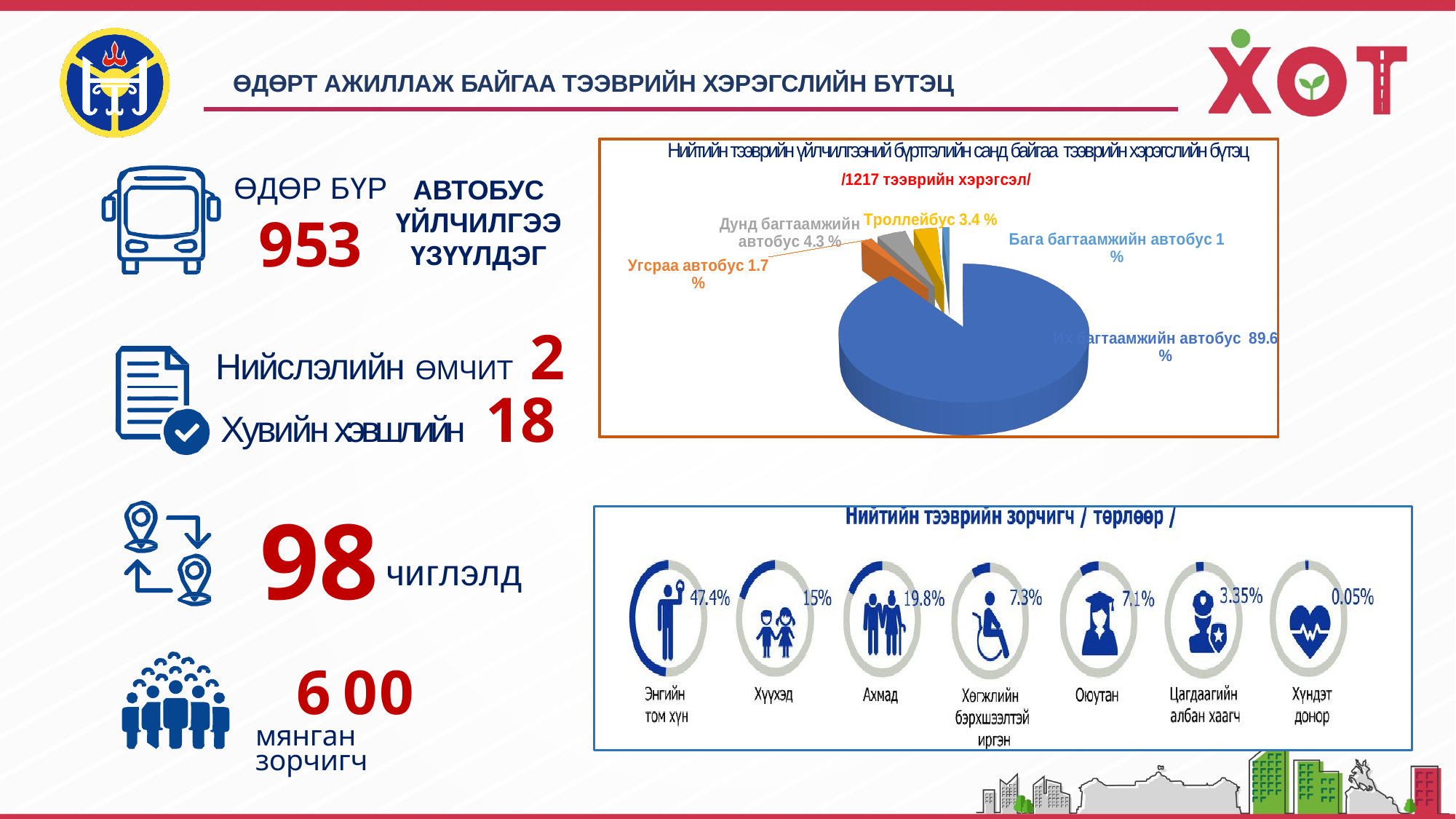
In the bottom-right infographic 'Нийтийн тээврийн зорчигч / төрлөөр /', what percentage is shown for Ахмад? 19.8% In the pie chart, what share is labelled for Их багтаамжийн автобус? 89.6 % What kind of chart is shown in the top-right box titled 'Нийтийн тээврийн үйлчилгээний бүртгэлийн санд байгаа тээврийн хэрэгслийн бүтэц'? Pie chart In the pie chart, which category has the smallest slice? Бага багтаамжийн автобус In the pie chart, how many slices (categories) are shown? 5 In the pie chart, what share is labelled for Троллейбус? 3.4 % According to the pie chart's title, how many vehicles are in the registry? 1217 In the pie chart, what share is labelled for Бага багтаамжийн автобус? 1 % In the pie chart, which category has the largest slice? Их багтаамжийн автобус In the pie chart, what share is labelled for Дунд багтаамжийн автобус? 4.3 % In the pie chart, which is larger: Троллейбус or Дунд багтаамжийн автобус? Дунд багтаамжийн автобус In the pie chart, what share is labelled for Угсраа автобус? 1.7 %